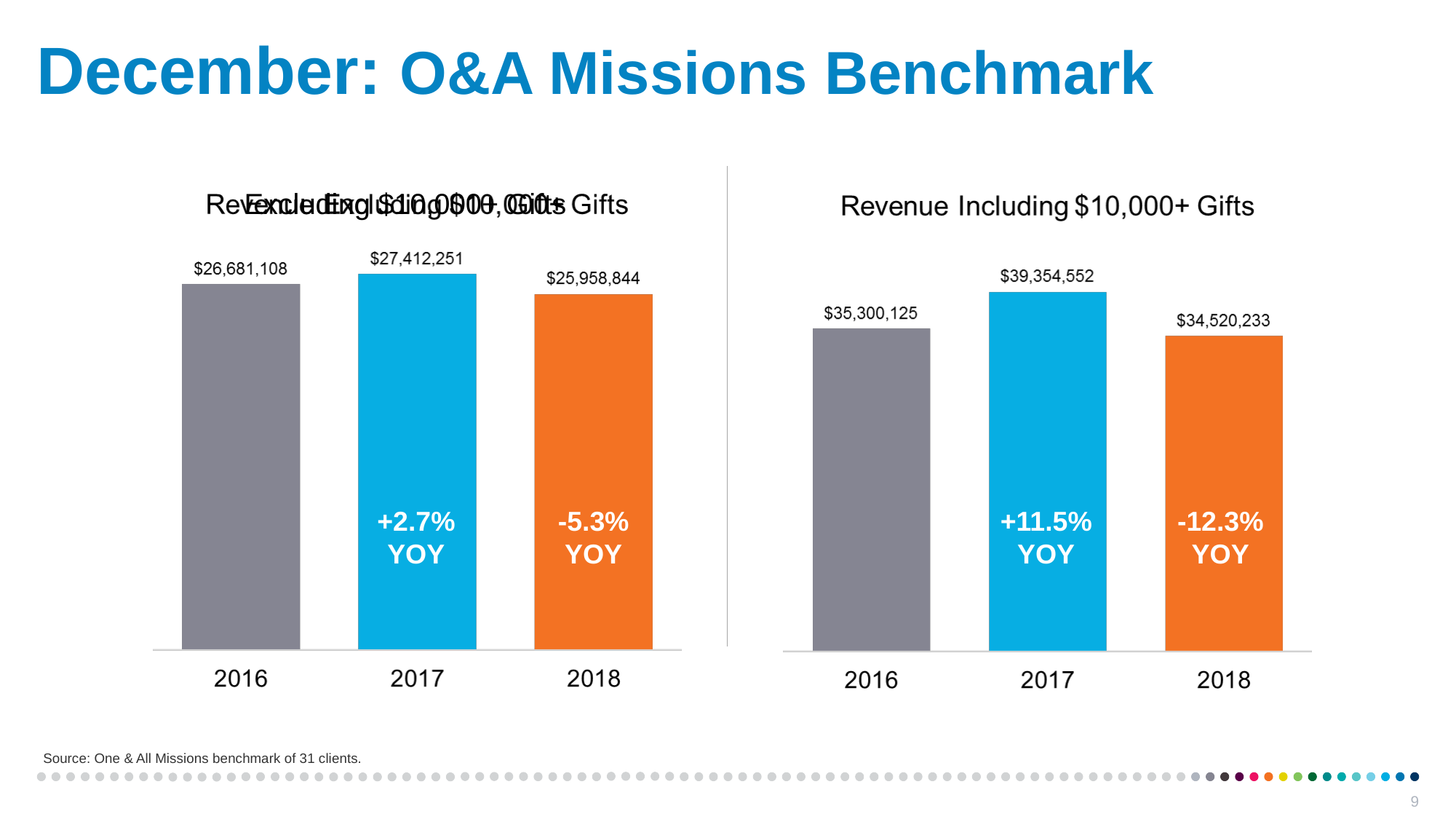
In the left chart, which year has the lowest value? 2018 In the chart titled Revenue Including $10,000+ Gifts, what year-over-year change is printed on the 2018 bar? -12.3% YOY How many years are shown in the chart titled Revenue Including $10,000+ Gifts? 3 In the left chart, which is larger, the value for 2016 or the value for 2018? 2016 What kind of chart is the chart titled Revenue Including $10,000+ Gifts? Bar chart In the chart titled Revenue Including $10,000+ Gifts, what is the value for 2018? $34,520,233 In the left chart, which year has the highest value? 2017 In the chart titled Revenue Including $10,000+ Gifts, what is the value for 2016? $35,300,125 In the left chart, what is the value for 2017? $27,412,251 In the chart titled Revenue Including $10,000+ Gifts, which year has the lowest value? 2018 In the left chart, what is the difference between the 2017 and 2016 values? $731,143 In the chart titled Revenue Including $10,000+ Gifts, what is the difference between the 2017 and 2018 values? $4,834,319